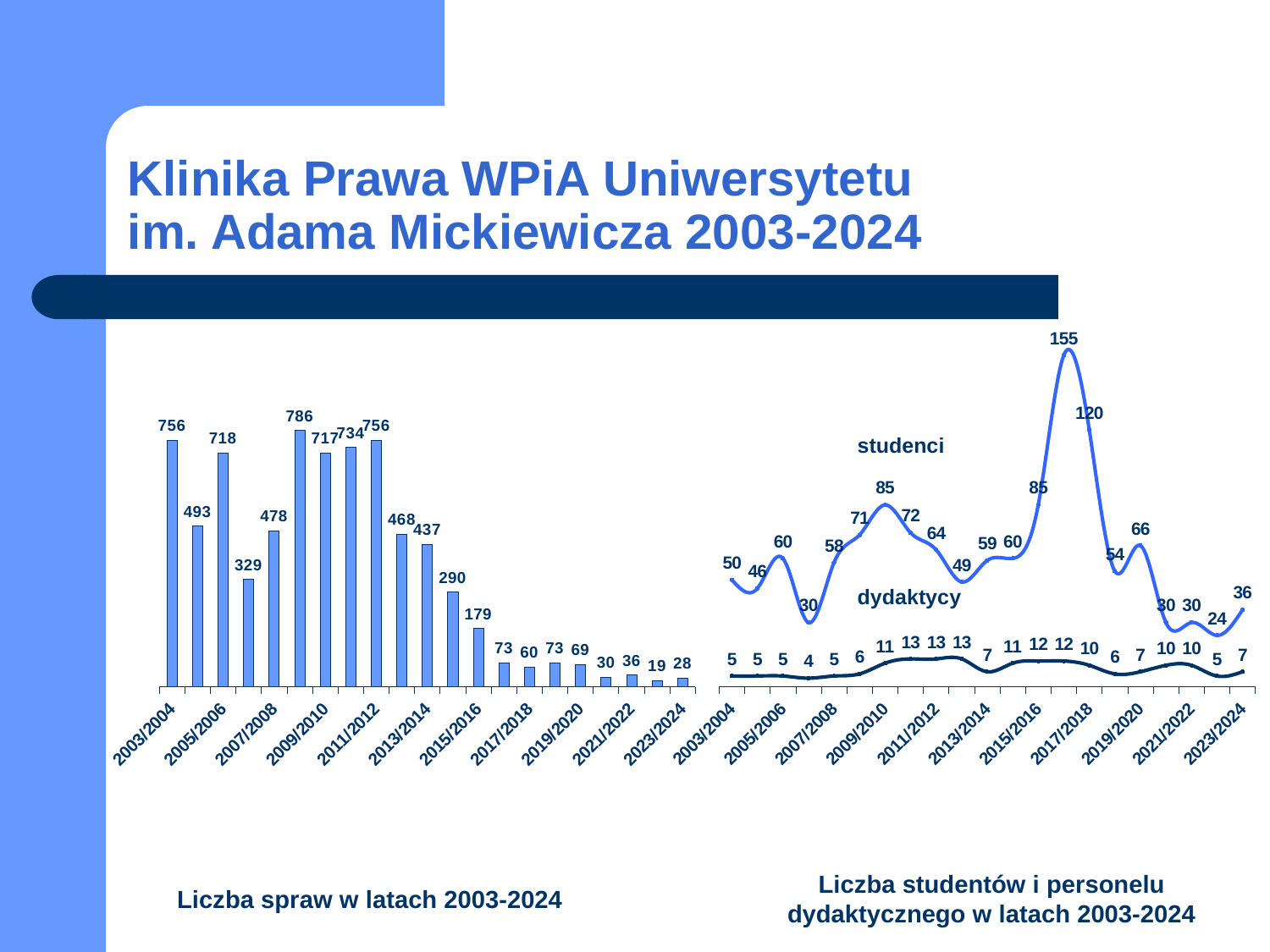
In the line chart 'Liczba studentów i personelu dydaktycznego w latach 2003-2024', what is the value for dydaktycy in 2023/2024? 7 In the line chart 'Liczba studentów i personelu dydaktycznego w latach 2003-2024', what is the highest value for studenci? 155 How many bars are in the bar chart 'Liczba spraw w latach 2003-2024'? 21 In the bar chart 'Liczba spraw w latach 2003-2024', what is the difference between the values for 2003/2004 and 2005/2006? 38 How many series are shown in the line chart 'Liczba studentów i personelu dydaktycznego w latach 2003-2024'? 2 In the line chart 'Liczba studentów i personelu dydaktycznego w latach 2003-2024', what is the value for studenci in 2015/2016? 85 In the bar chart 'Liczba spraw w latach 2003-2024', what is the value for 2023/2024? 28 What kind of chart is 'Liczba spraw w latach 2003-2024'? Bar chart In the bar chart 'Liczba spraw w latach 2003-2024', what is the value for 2003/2004? 756 In the bar chart 'Liczba spraw w latach 2003-2024', what is the highest value shown? 786 In the bar chart 'Liczba spraw w latach 2003-2024', what is the lowest value shown? 19 In the line chart 'Liczba studentów i personelu dydaktycznego w latach 2003-2024', which year has the larger studenci value, 2003/2004 or 2023/2024? 2003/2004